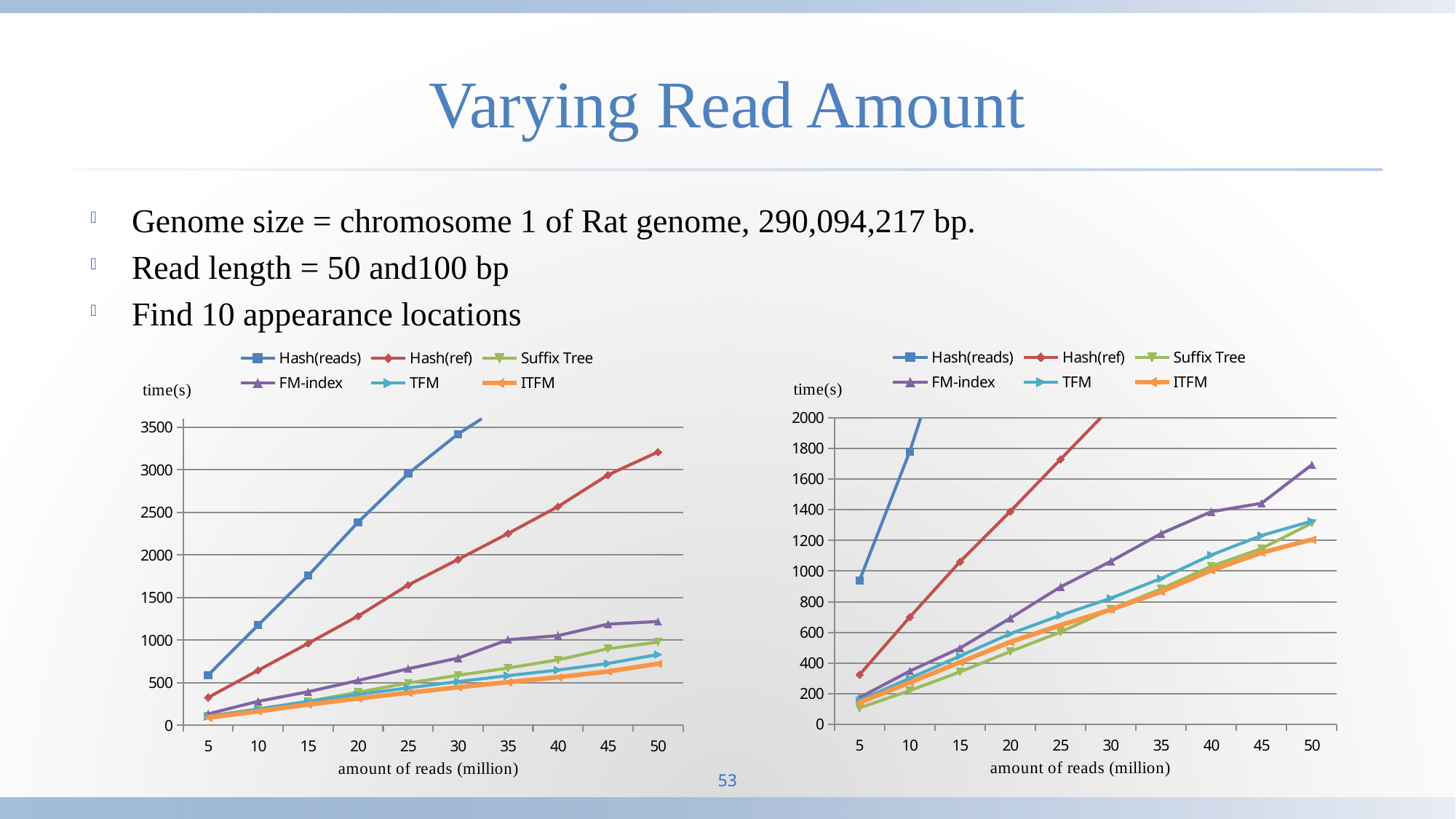
What kind of chart is the left chart on the slide? line chart What is the x-axis label of the right chart? amount of reads (million) In the left chart, is the value for Hash(ref) at 50 million reads greater or less than 3000? greater In the left chart, is the value for Hash(reads) at 30 million reads greater or less than 3000? greater In the left chart, is the value for ITFM at 50 million reads greater or less than 1000? less In the right chart, which series has the lowest value at 50 million reads? ITFM How many amount-of-reads values are marked on the x axis of the left chart? 10 In the left chart, does the Hash(ref) series rise or fall as the amount of reads increases? rise In the left chart, which is larger at 50 million reads, Hash(ref) or FM-index? Hash(ref) How many series does the legend of the right chart list? 6